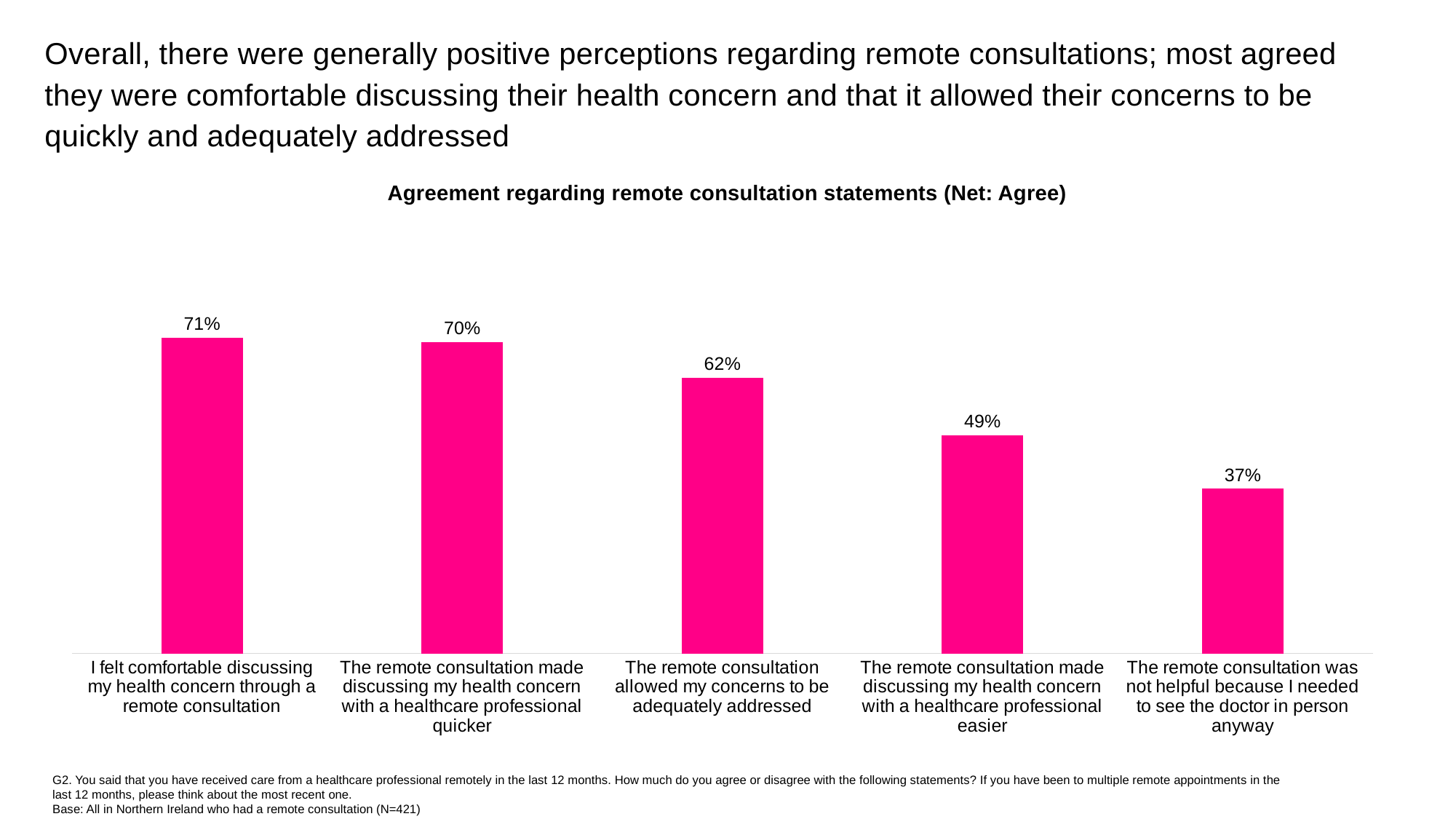
Which statement has the lowest level of agreement? The remote consultation was not helpful because I needed to see the doctor in person anyway Which statement has the highest level of agreement? I felt comfortable discussing my health concern through a remote consultation What is the value for 'The remote consultation made discussing my health concern with a healthcare professional easier'? 49% What type of chart is shown on the slide? Bar chart What percentage agreed with the statement 'I felt comfortable discussing my health concern through a remote consultation'? 71% What is the value for 'The remote consultation allowed my concerns to be adequately addressed'? 62% Do the values rise or fall from left to right across the chart? Fall What is the difference between the agreement for 'The remote consultation made discussing my health concern with a healthcare professional quicker' and 'The remote consultation made discussing my health concern with a healthcare professional easier'? 21% What is the title of the chart? Agreement regarding remote consultation statements (Net: Agree) Which has a higher agreement: 'The remote consultation allowed my concerns to be adequately addressed' or 'The remote consultation was not helpful because I needed to see the doctor in person anyway'? The remote consultation allowed my concerns to be adequately addressed How many statements are shown in the chart? 5 What percentage agreed that the remote consultation was not helpful because they needed to see the doctor in person anyway? 37%